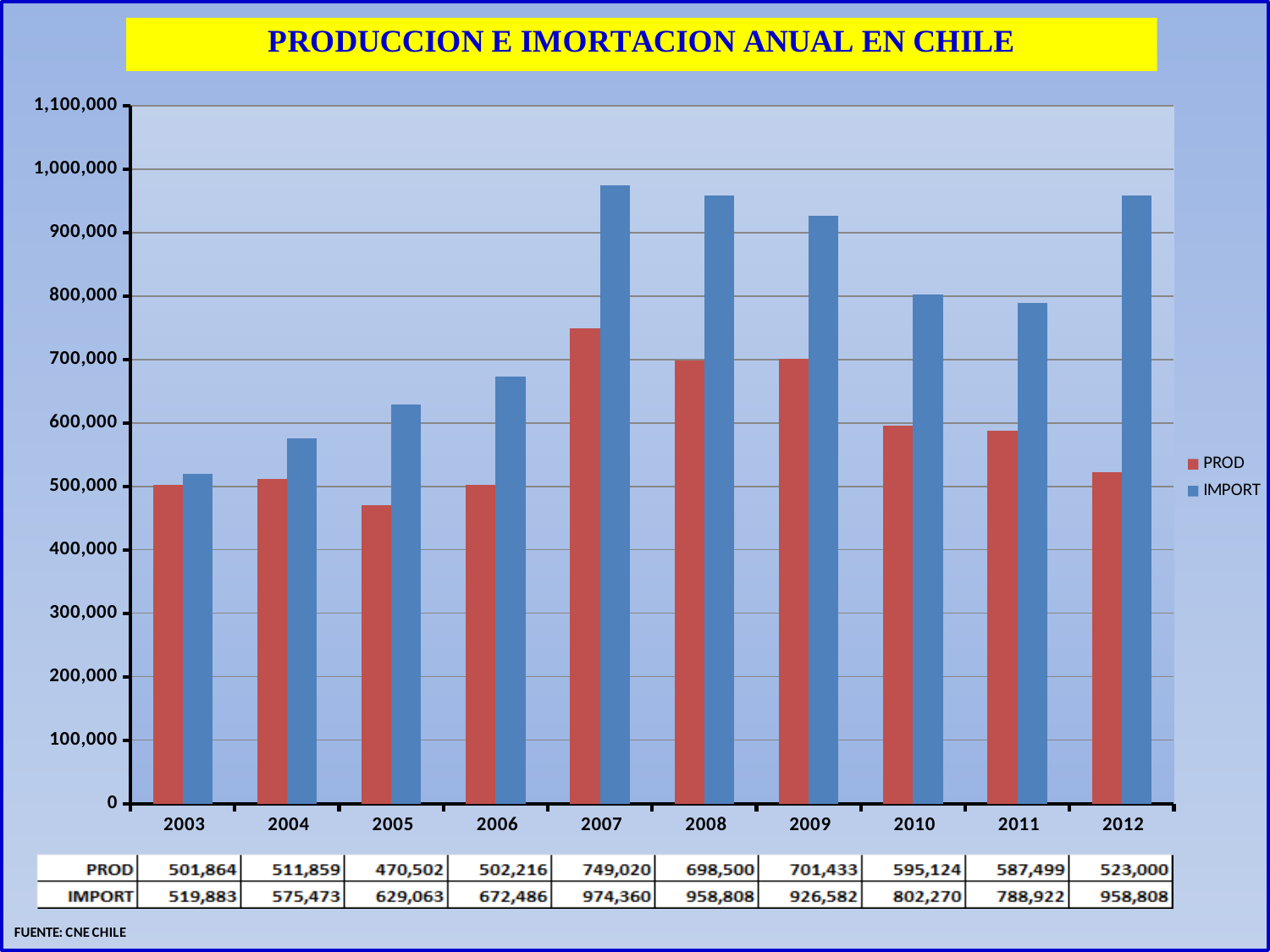
How many years are shown on the x axis? 10 Which year has the highest IMPORT value? 2007 What is the difference between IMPORT and PROD in 2012? 435,808 Is the IMPORT value for 2011 greater or less than 700,000? greater What is the PROD value for 2007? 749,020 Which year has the lowest IMPORT value? 2003 What is the PROD value for 2012? 523,000 How many series does the legend list? 2 Which is larger in 2009, PROD or IMPORT? IMPORT What is the IMPORT value for 2010? 802,270 Which year has the lowest PROD value? 2005 What kind of chart is shown on the slide? bar chart